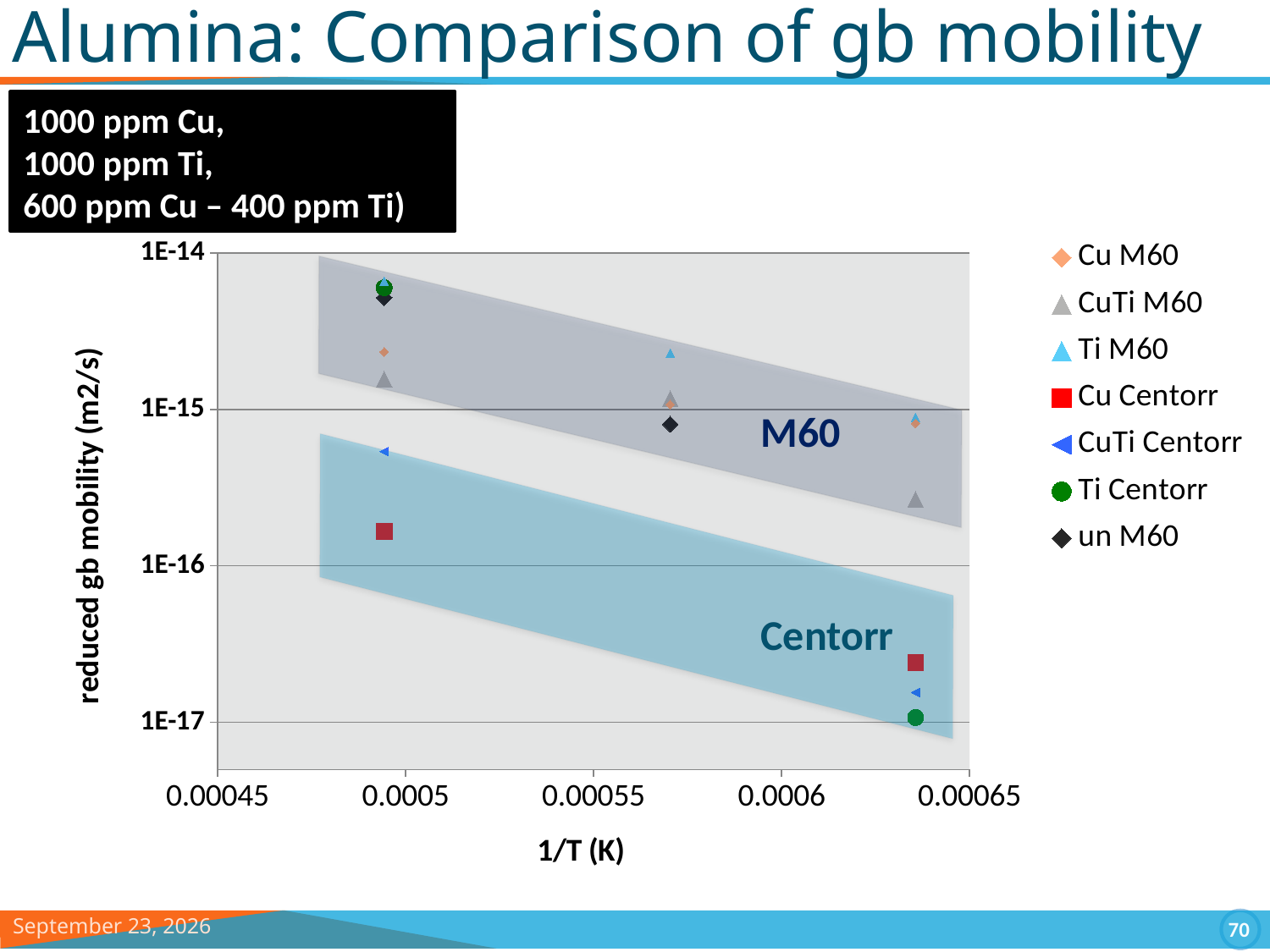
What is the label of the y axis? reduced gb mobility (m2/s) Is the CuTi M60 value near 1/T = 0.00064 greater or less than 1E-16? greater What kind of chart is shown on the slide? scatter chart Is the Cu Centorr value near 1/T = 0.0005 greater or less than 1E-16? greater How many series does the legend list? 7 Which shaded band lies higher on the chart, M60 or Centorr? M60 Is the Cu Centorr value near 1/T = 0.0005 greater or less than 1E-15? less Near 1/T = 0.0005, which is larger: the Cu M60 value or the Cu Centorr value? Cu M60 What is the label of the x axis? 1/T (K) Which series has the lowest plotted point on the chart? Ti Centorr Do the plotted mobility values rise or fall as 1/T increases along the x axis? fall